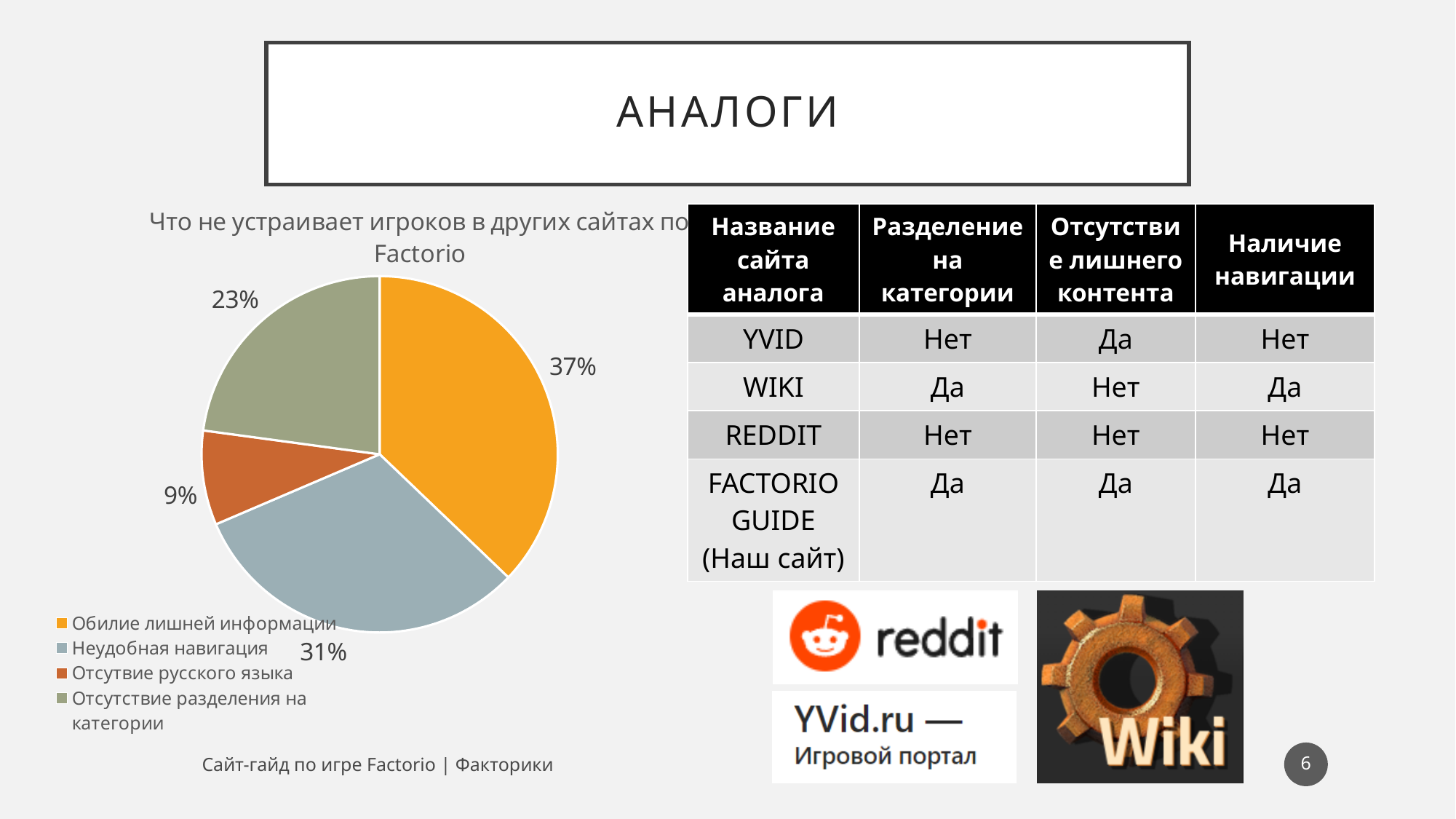
What share of the pie does "Отсутвие русского языка" have? 9% Which is larger: the slice for "Отсутствие разделения на категории" or the slice for "Отсутвие русского языка"? Отсутствие разделения на категории Which category has the smallest slice of the pie? Отсутвие русского языка How many entries does the legend of the pie chart list? 4 What is the difference in percentage points between "Обилие лишней информации" and "Неудобная навигация"? 6% What share of the pie does "Неудобная навигация" have? 31% What kind of chart is shown on the slide? pie chart What colour is the slice for "Неудобная навигация"? gray-blue How many slices does the pie chart have? 4 What share of the pie does "Обилие лишней информации" have? 37% Which category has the largest slice of the pie? Обилие лишней информации